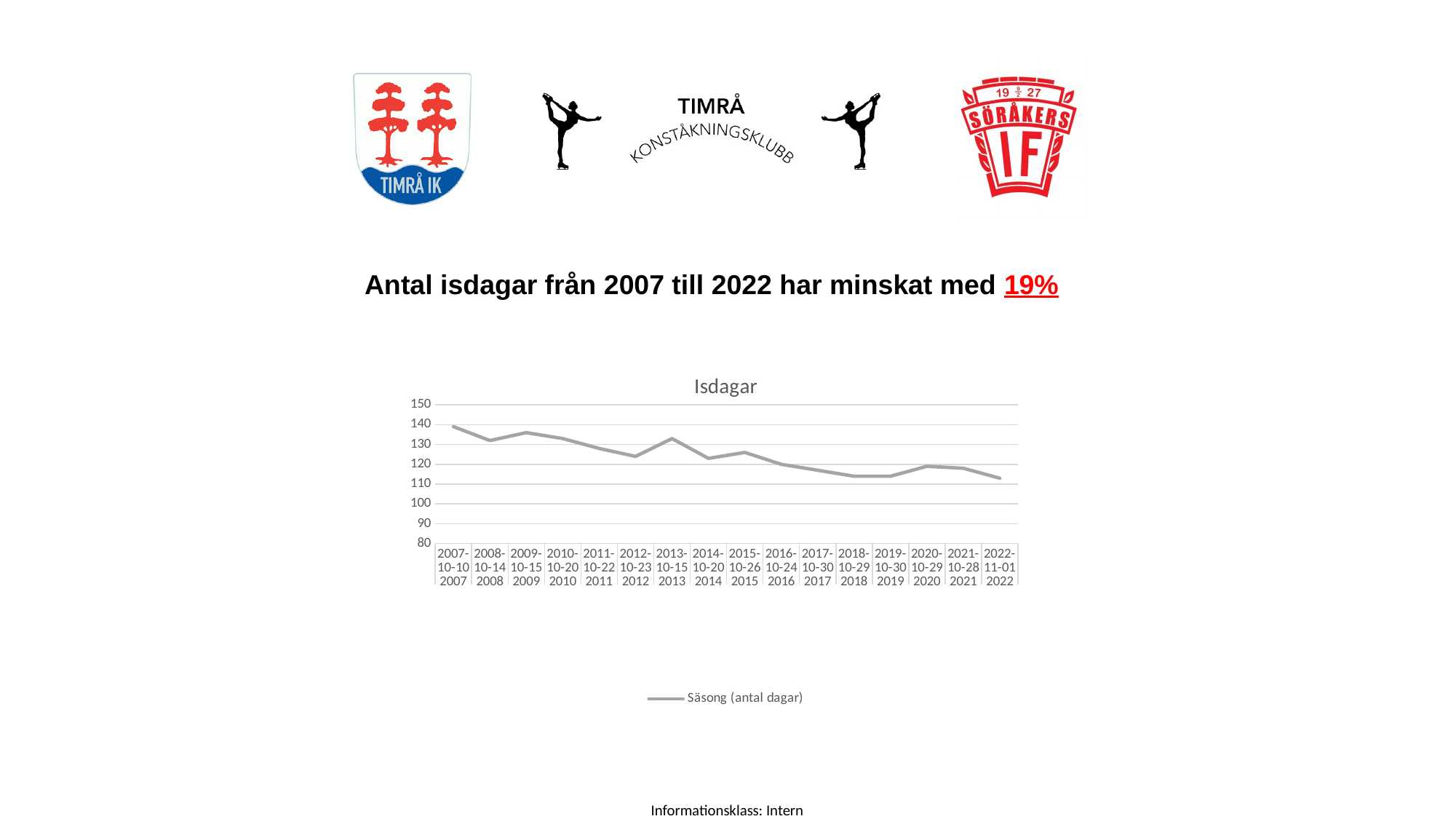
How many seasons (data points) are plotted along the x axis? 16 Is the value for the 2022 season greater or less than 120? less How many series does the chart legend list? 1 Is the value for the 2013 season greater or less than 130? greater Is the value for the 2018 season greater or less than 120? less Do the values generally rise or fall from 2007 to 2022? fall What is the title of the chart? Isdagar Which season has the larger value, 2007 or 2022? 2007 Which season has the larger value, 2012 or 2013? 2013 What is the name of the series shown in the chart legend? Säsong (antal dagar) What kind of chart is shown on the slide? line chart